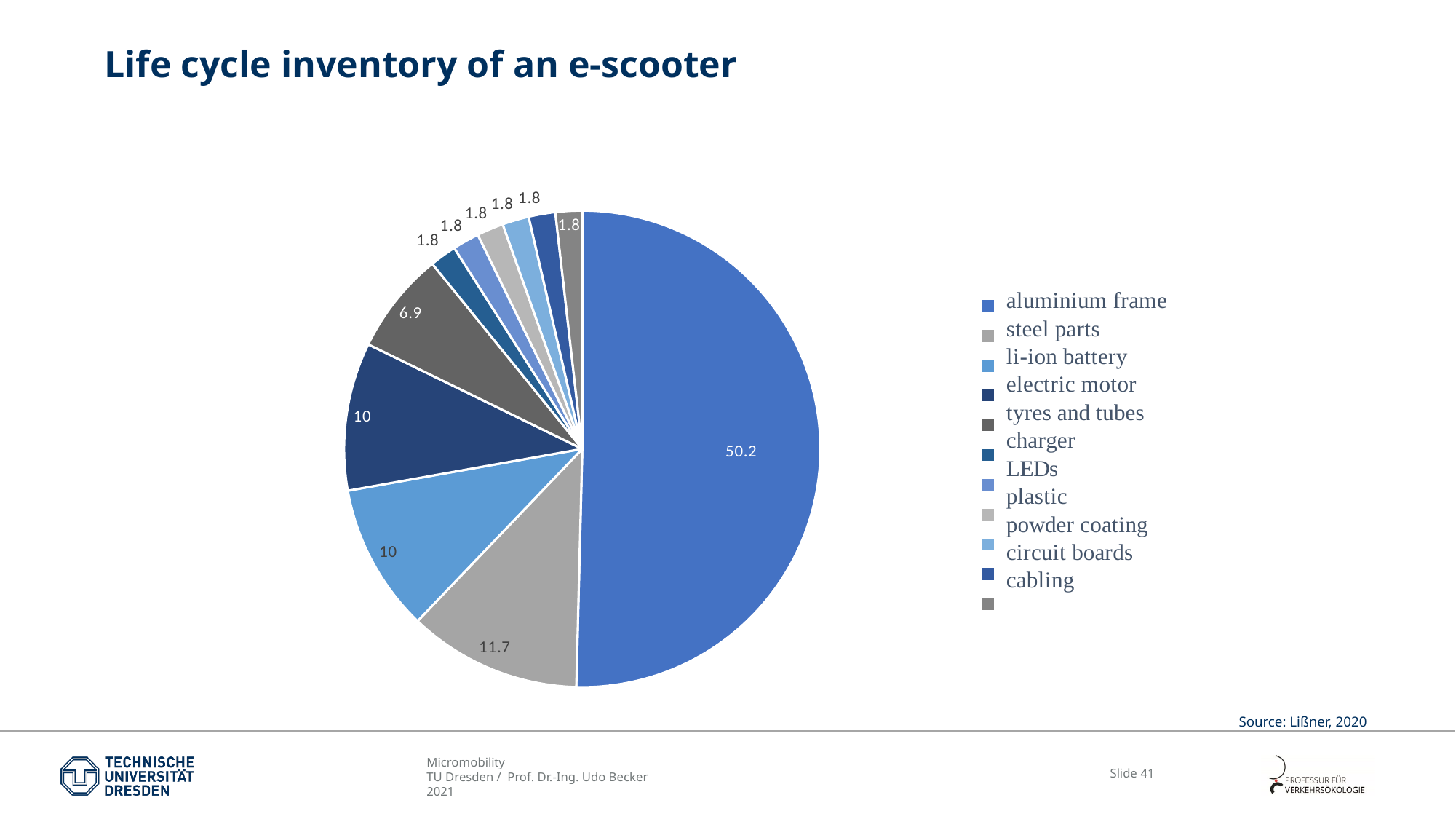
What is the difference between the aluminium frame value and the steel parts value? 38.5 Which component has the largest slice of the pie? aluminium frame What is the title of the slide containing the pie chart? Life cycle inventory of an e-scooter What kind of chart is shown on the slide? pie chart What value is shown for the li-ion battery slice? 10 Which is larger, the steel parts slice or the tyres and tubes slice? steel parts How many slices does the pie chart have? 11 What value is shown for the tyres and tubes slice? 6.9 What value is shown for the steel parts slice? 11.7 What value is shown for the aluminium frame slice? 50.2 What value is shown for the charger slice? 1.8 What is the difference between the tyres and tubes value and the charger value? 5.1